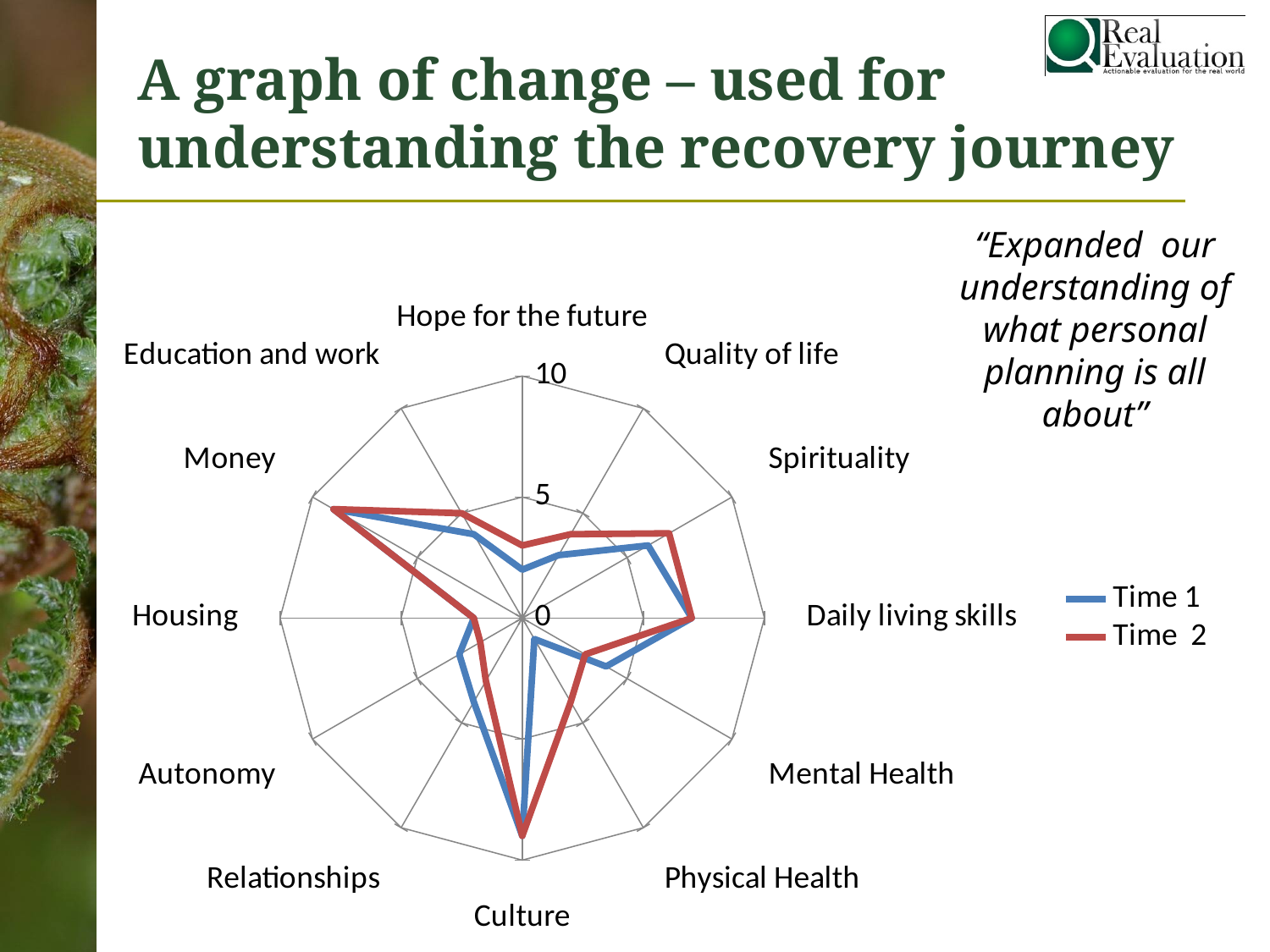
Is the Time 1 value for Physical Health greater or less than 5? less What are the two series named in the legend? Time 1 and Time 2 How many categories (axes) does the radar chart have? 12 What colour is the Time 2 line? Red Is the Time 1 value for Culture greater or less than 5? greater What kind of chart is shown on the slide? Radar chart Which category has the highest value for Time 2? Culture and Money (tied) How many series does the legend list? 2 For Time 2, which is larger: the value for Money or the value for Housing? Money Is the Time 2 value for Money greater or less than 5? greater